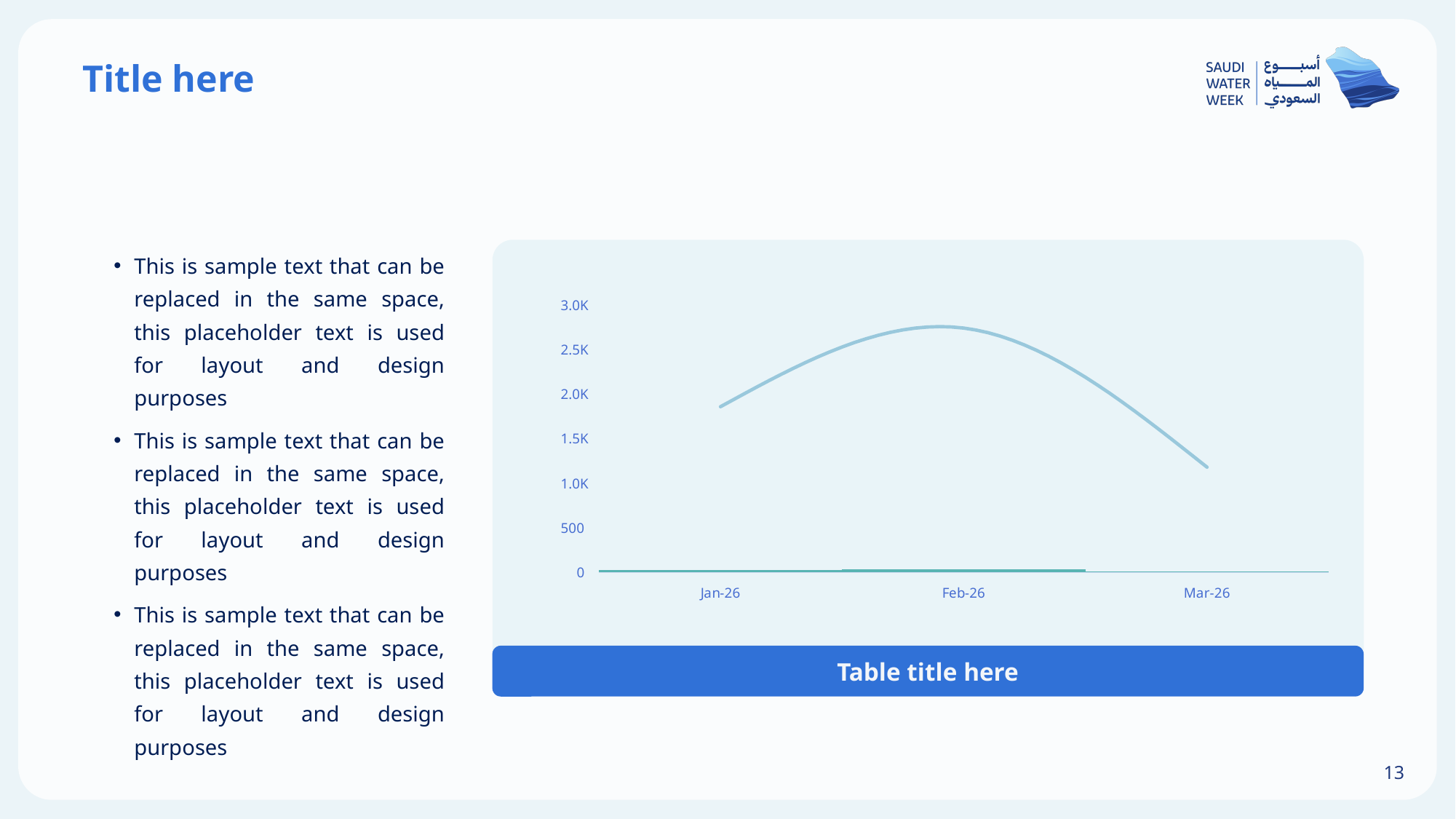
How does the line move from Jan-26 to Mar-26? rises then falls Is the value for Feb-26 greater or less than 2.5K? greater Which month has the lowest value on the chart? Mar-26 Which month has the highest value on the chart? Feb-26 Is the value for Mar-26 greater or less than 1.5K? less How many data points are plotted along the x axis of the chart? 3 Which is larger, the value for Jan-26 or the value for Mar-26? Jan-26 Is the value for Feb-26 greater or less than 3.0K? less What is the title shown in the bar beneath the chart? Table title here What kind of chart is shown on the slide? line chart Which is larger, the value for Jan-26 or the value for Feb-26? Feb-26